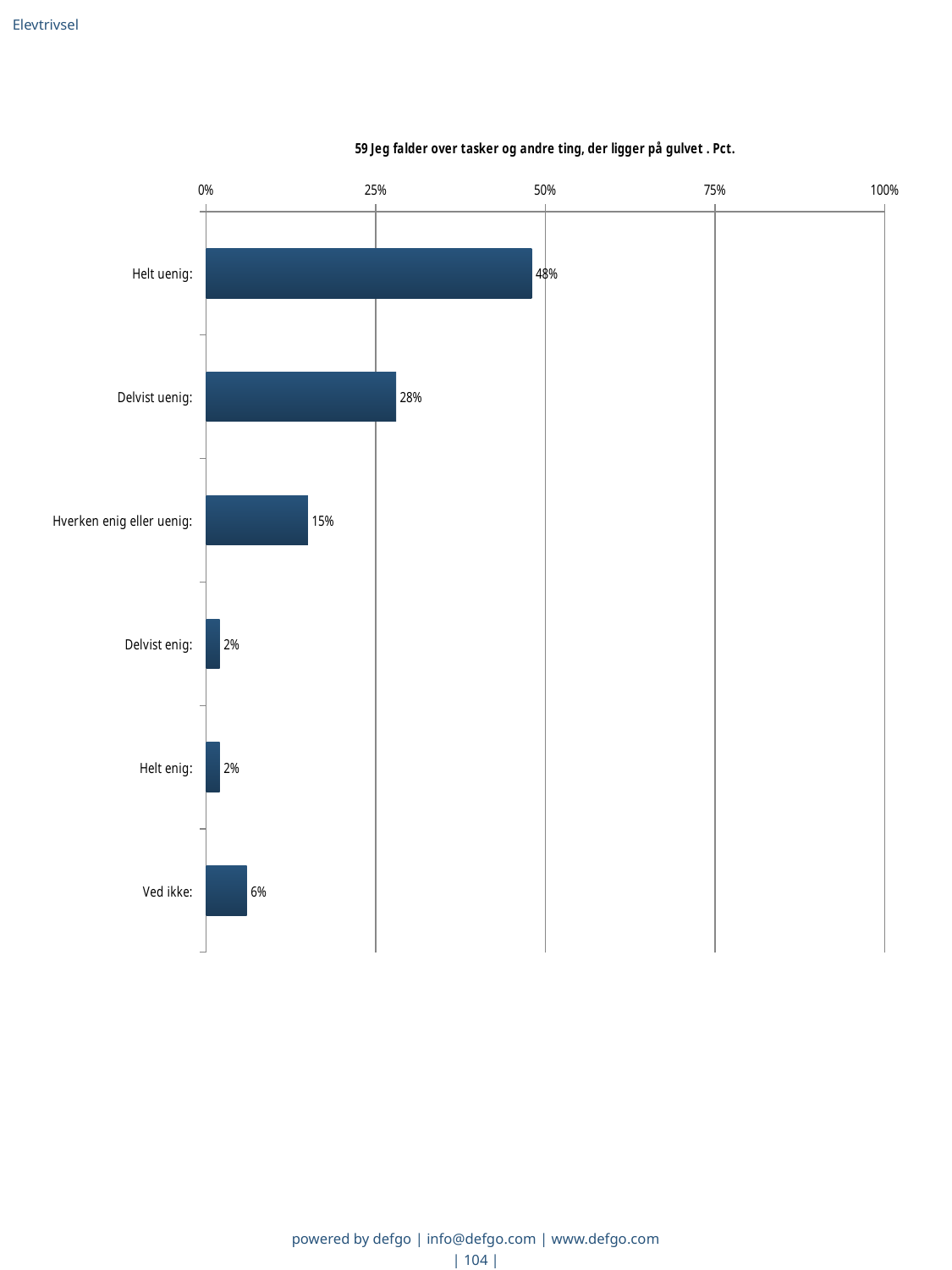
What is the value for "Helt uenig"? 48% What is the title of the chart? 59 Jeg falder over tasker og andre ting, der ligger på gulvet . Pct. What is the difference between the values for "Helt uenig" and "Delvist uenig"? 20% Which is larger, the value for "Delvist uenig" or the value for "Ved ikke"? Delvist uenig What is the value for "Delvist uenig"? 28% How many categories are shown in the chart? 6 What kind of chart is shown on the slide? Bar chart Which category has the highest value? Helt uenig What is the difference between the values for "Hverken enig eller uenig" and "Ved ikke"? 9% Is the value for "Delvist uenig" greater or less than 25%? greater What is the value for "Ved ikke"? 6% What is the value for "Hverken enig eller uenig"? 15%